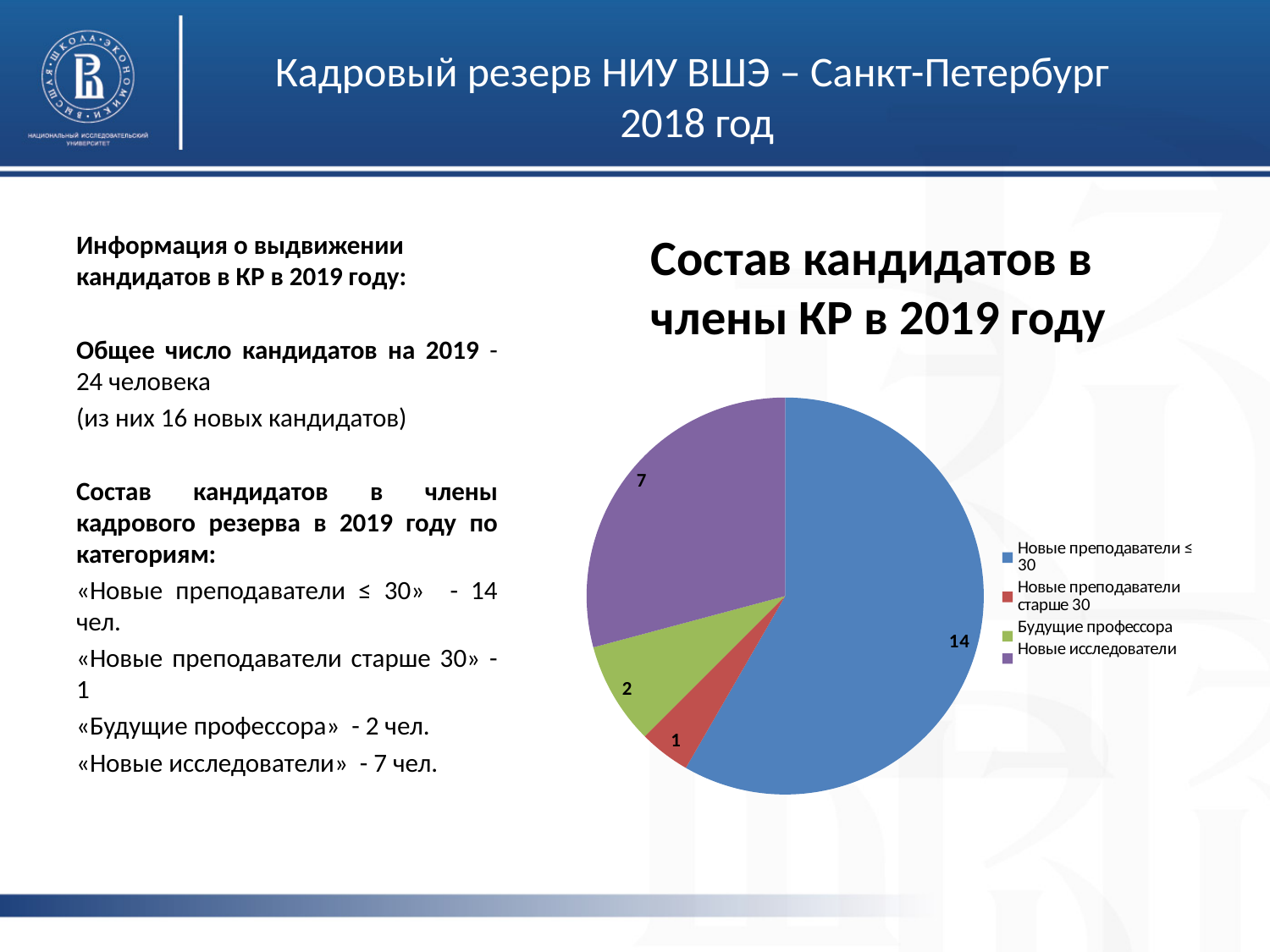
What is the difference between the values for «Новые преподаватели ≤ 30» and «Новые исследователи»? 7 Which category has the largest slice in the pie chart? Новые преподаватели ≤ 30 What is the value for «Новые исследователи» in the pie chart? 7 How many entries does the chart legend list? 4 Which category has the smallest slice in the pie chart? Новые преподаватели старше 30 How many slices does the pie chart have? 4 What is the value for «Будущие профессора» in the pie chart? 2 What type of chart is shown on the slide? pie chart What is the value for «Новые преподаватели старше 30» in the pie chart? 1 Which is larger in the pie chart: «Будущие профессора» or «Новые исследователи»? Новые исследователи What is the value for «Новые преподаватели ≤ 30» in the pie chart? 14 What is the title of the chart on the slide? Состав кандидатов в члены КР в 2019 году